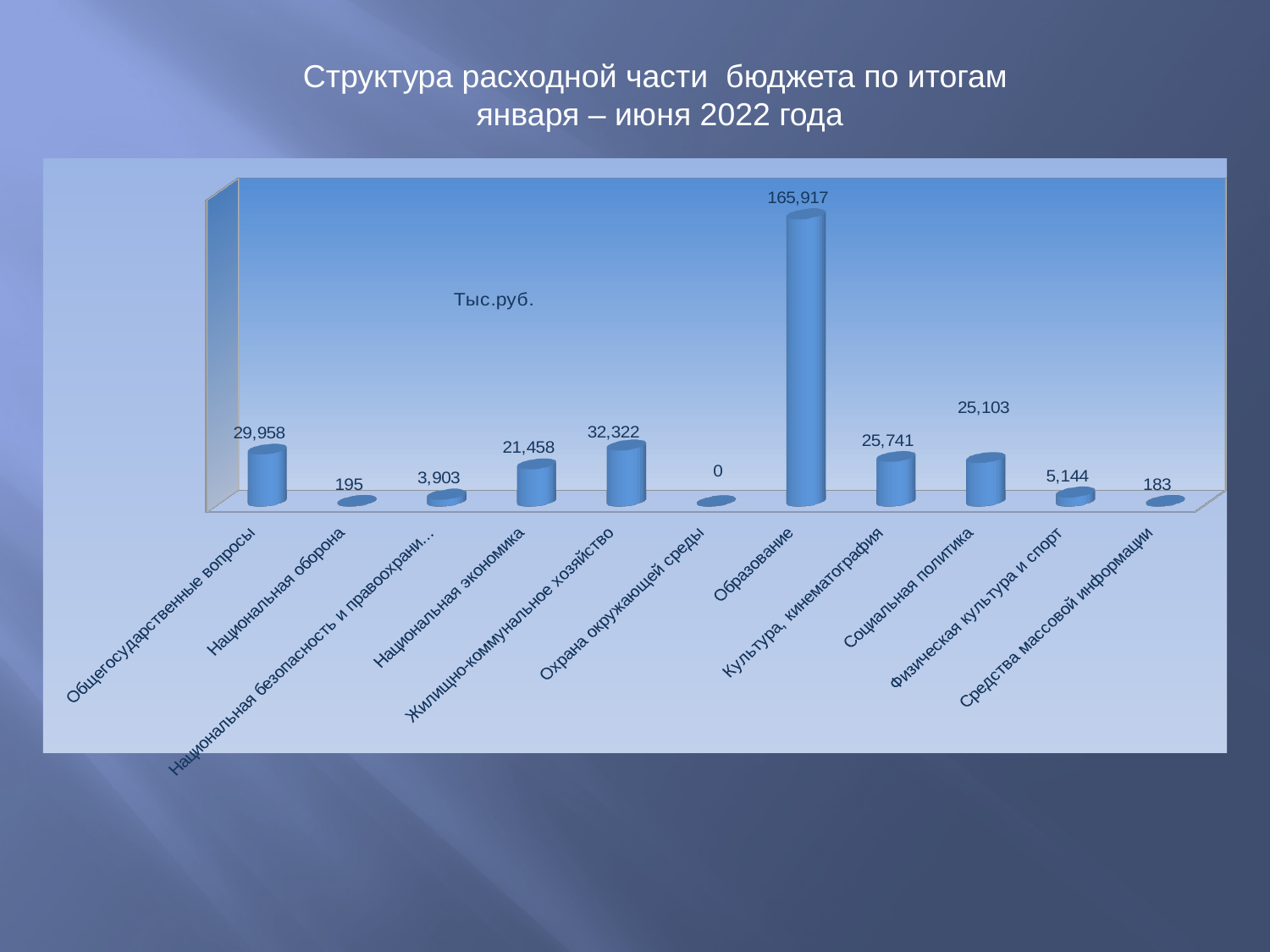
How many categories are shown on the chart? 11 What is the value for Национальная оборона? 195 Which category has the highest value? Образование What kind of chart is shown on the slide? Bar chart What unit is indicated on the chart? Тыс.руб. What is the difference between the values for Образование and Жилищно-коммунальное хозяйство? 133,595 What is the value for Физическая культура и спорт? 5,144 What is the value for Образование? 165,917 Which is larger, the value for Культура, кинематография or the value for Социальная политика? Культура, кинематография What is the value for Жилищно-коммунальное хозяйство? 32,322 What is the difference between the values for Общегосударственные вопросы and Национальная экономика? 8,500 Which category has the lowest value? Охрана окружающей среды